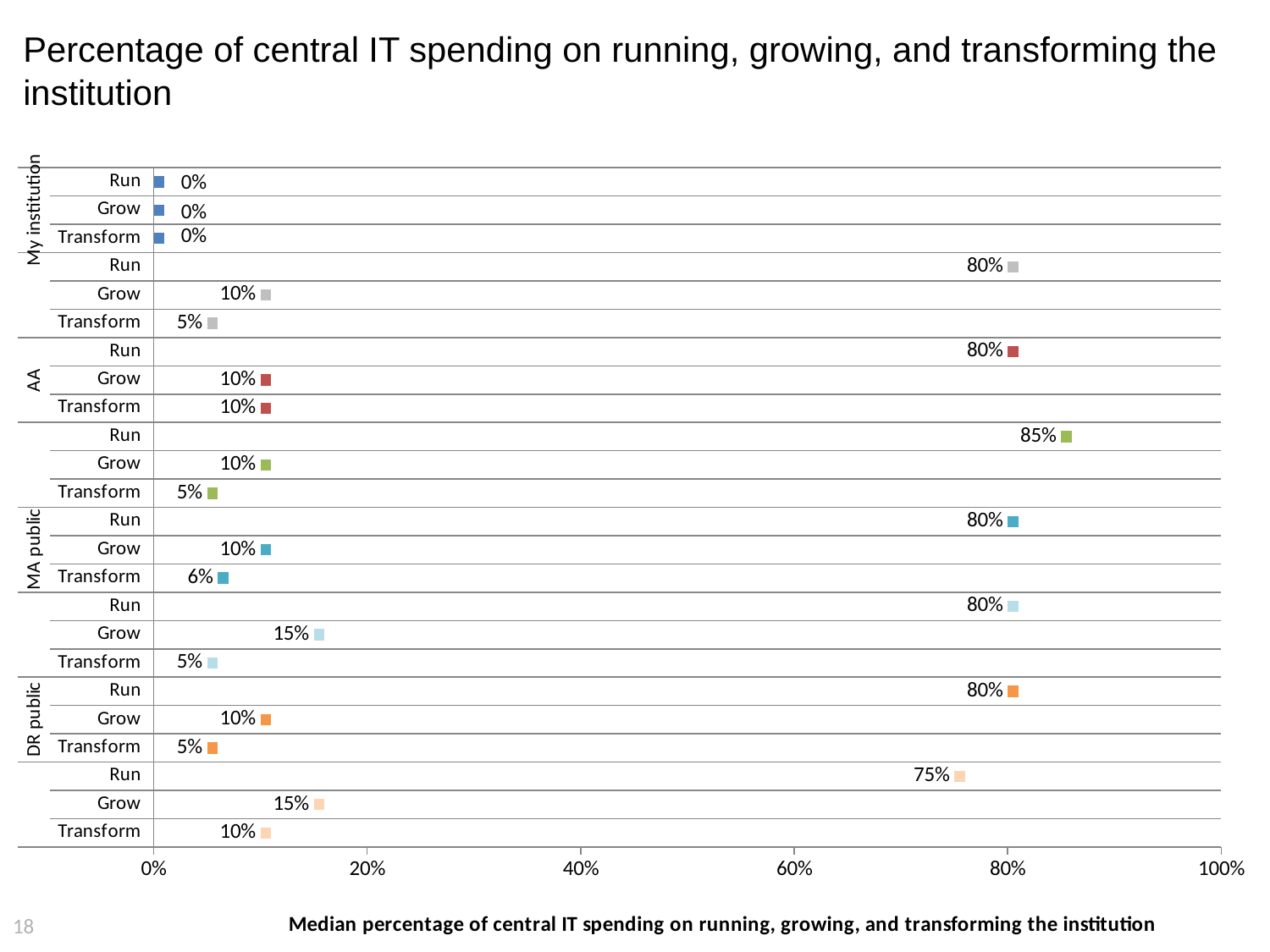
What is the Transform value for MA public? 6% What is the highest value labelled anywhere on the chart? 85% What is the Run value for AA? 80% What caption appears below the chart? Median percentage of central IT spending on running, growing, and transforming the institution What is the difference between the Run and Grow values for AA? 70% What do the Run, Grow and Transform values for AA add up to? 100% Which is larger, the Transform value for MA public or the Transform value for DR public? MA public What is the Grow value for DR public? 10% What is the maximum value shown on the x axis? 100% What is the Transform value for AA? 10% Is the Run value for DR public greater or less than 60%? greater What is the Run value for My institution? 0%